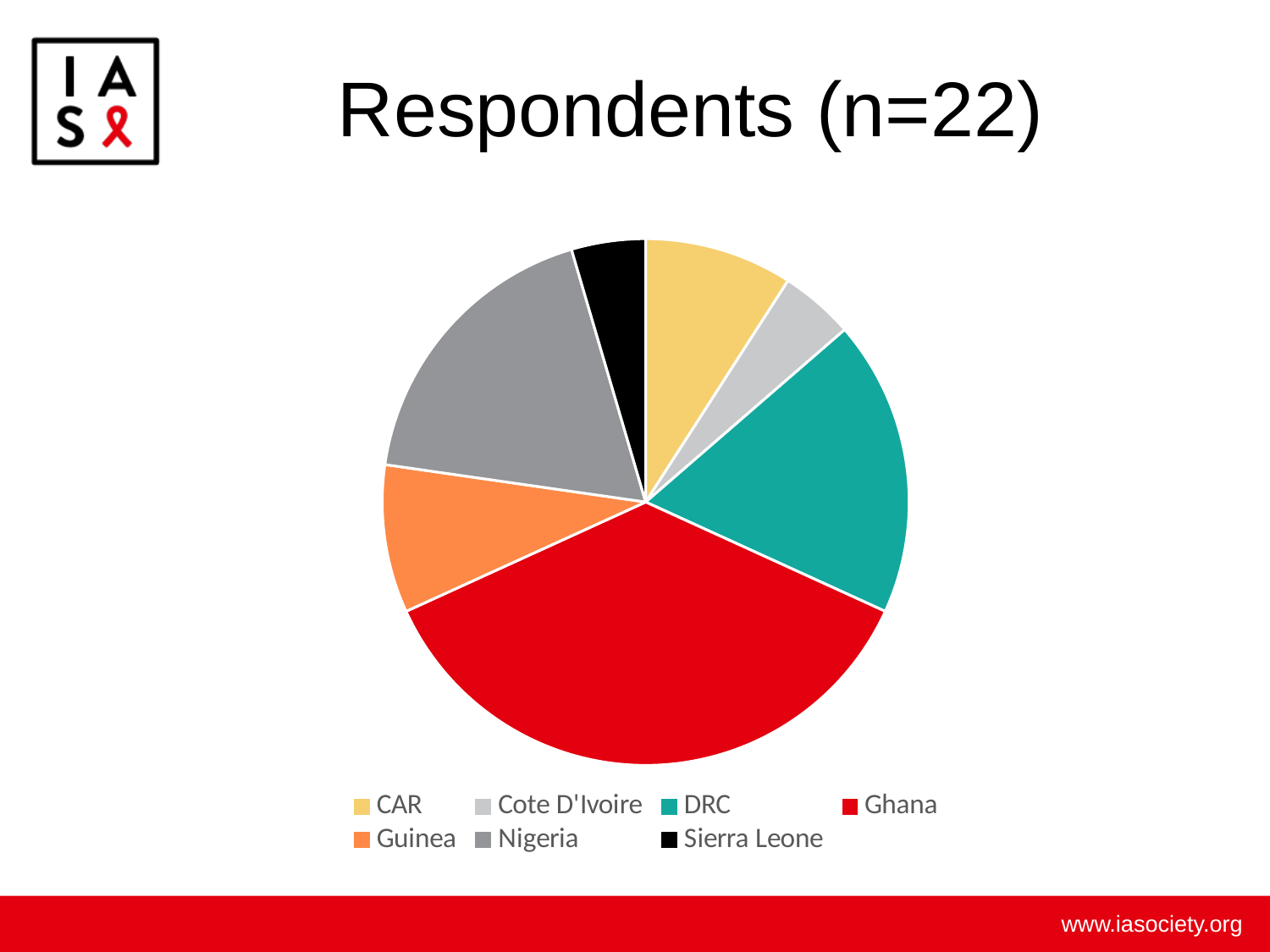
Which slice is larger, Nigeria or Guinea? Nigeria Which slice is larger, Ghana or Nigeria? Ghana What colour represents Ghana in the pie chart? red What kind of chart is shown on the slide? pie chart Which slice is larger, Ghana or DRC? Ghana Which country has the largest slice of the pie chart? Ghana How many countries are shown in the pie chart? 7 What is the title of the chart? Respondents (n=22)